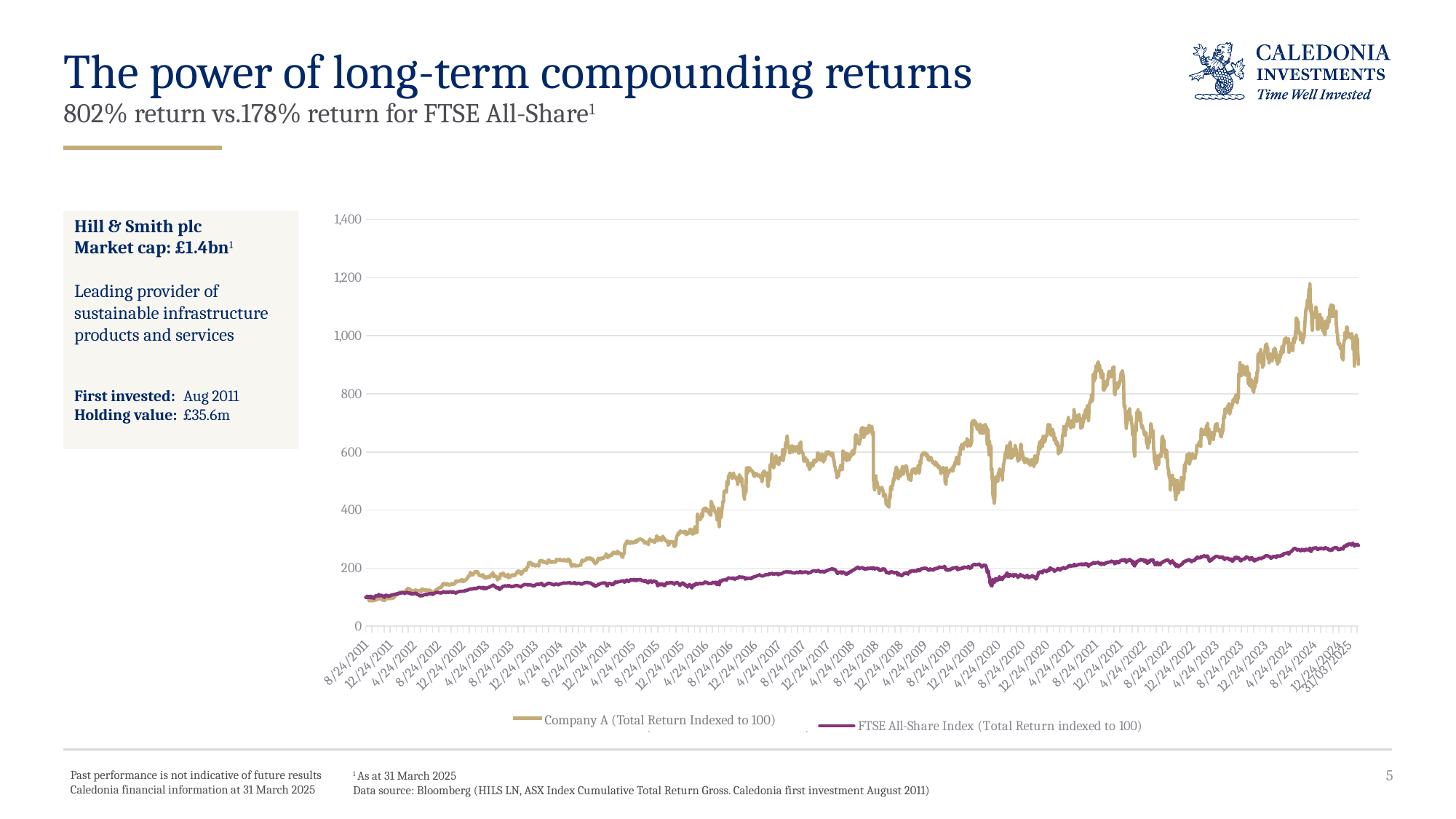
Is the highest value reached by the Company A line greater or less than 1,000? greater What is the highest tick value shown on the chart's vertical axis? 1,400 What colour is the line for the FTSE All-Share Index? purple Is the value for Company A at 8/24/2016 greater or less than 400? greater Does the Company A line generally rise or fall from 8/24/2011 to 31/03/2025? rise What kind of chart is shown on the slide? line chart How many series does the chart's legend list? 2 Is the value for the FTSE All-Share Index at 31/03/2025 greater or less than 400? less What value are both series indexed to at the start of the chart, according to the legend? 100 At the end of the period (31/03/2025), which series is higher: Company A or the FTSE All-Share Index? Company A Which series reaches the highest value on the chart? Company A (Total Return Indexed to 100)